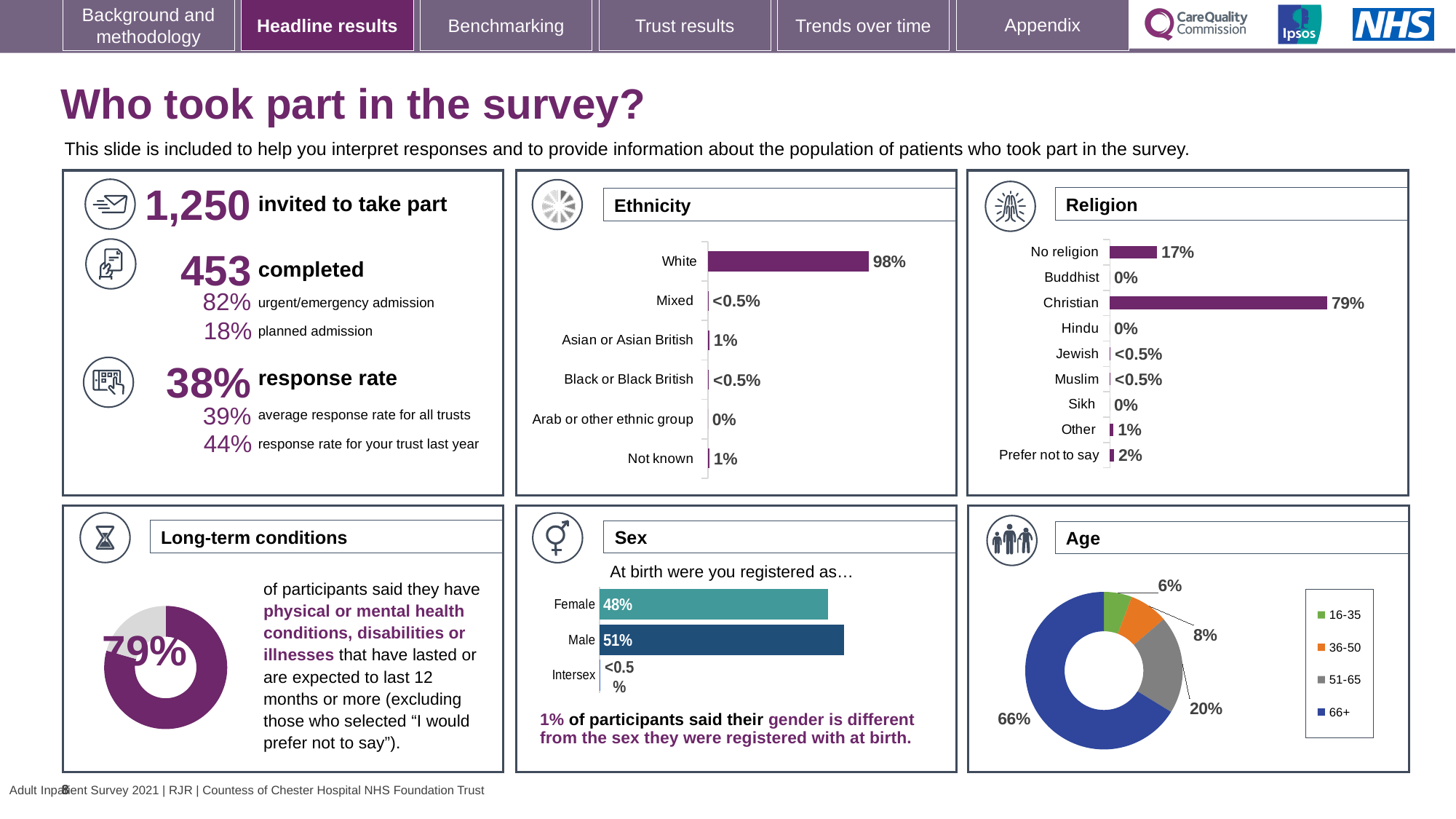
In the Ethnicity chart, what percentage of participants were White? 98% In the Age chart, which age group has the smallest share? 16-35 In the Age chart, what share of participants were aged 66+? 66% How many categories are shown in the Ethnicity chart? 6 How many categories are shown in the Religion chart? 9 What kind of chart is used in the Long-term conditions panel? Donut chart In the Sex chart, what percentage of participants were registered as Female at birth? 48% In the Religion chart, what is the difference between the Christian and No religion values? 62% In the Sex chart, which is larger, the Male value or the Female value? Male In the Ethnicity chart, which category has the highest value? White How many entries does the legend of the Age chart list? 4 In the Religion chart, what percentage of participants were Christian? 79%